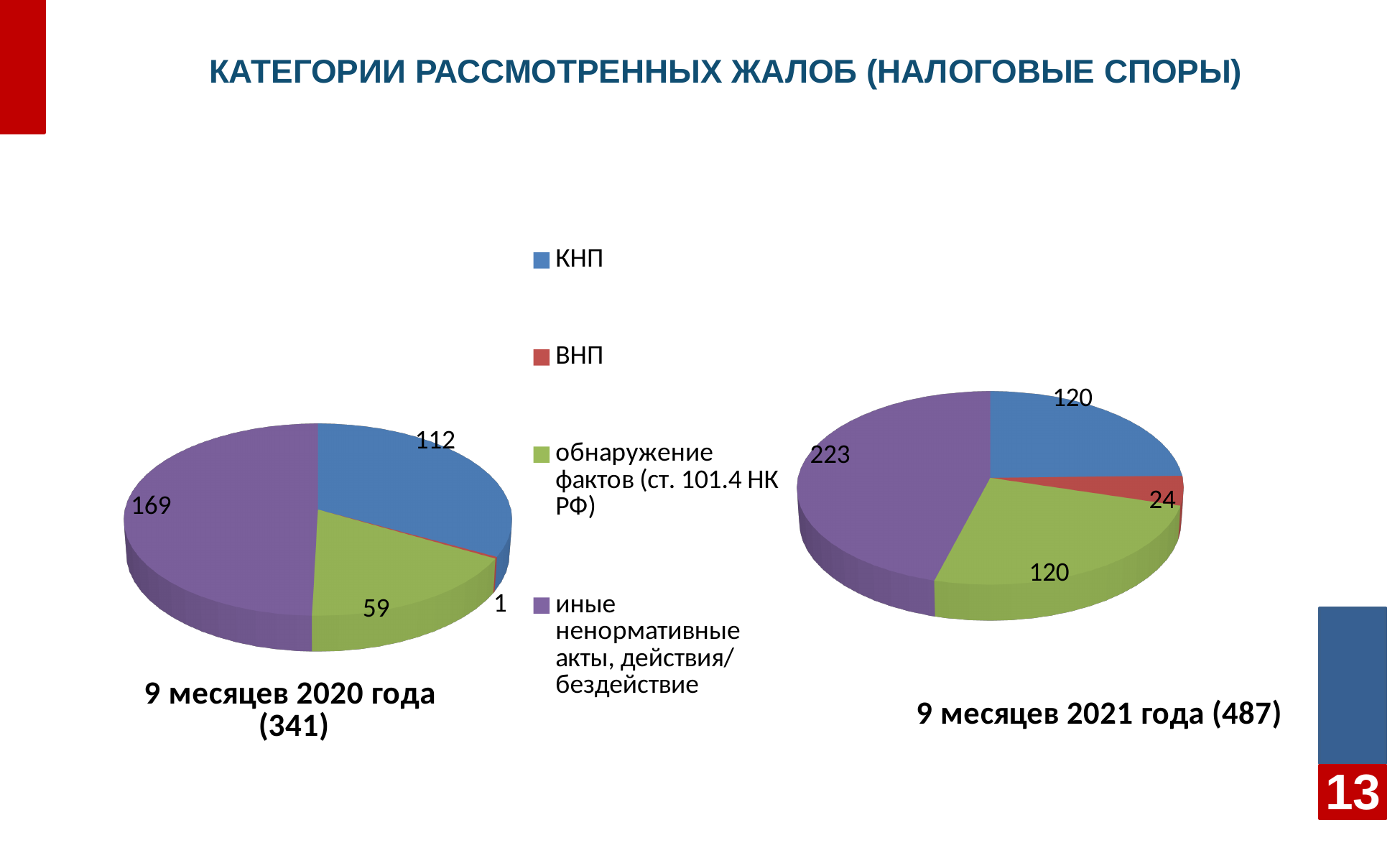
Which colour represents ВНП in the legend? Red In the pie chart titled "9 месяцев 2020 года (341)", what is the value for КНП? 112 What type of chart is used on the slide? Pie chart How many categories does each pie chart on the slide show? 4 In the pie chart titled "9 месяцев 2021 года (487)", what is the difference between the values for иные ненормативные акты, действия/бездействие and КНП? 103 In the pie chart titled "9 месяцев 2020 года (341)", which category has the largest slice? иные ненормативные акты, действия/бездействие In the pie chart titled "9 месяцев 2020 года (341)", which is larger: КНП or обнаружение фактов (ст. 101.4 НК РФ)? КНП In the pie chart titled "9 месяцев 2021 года (487)", what is the value for ВНП? 24 In the pie chart titled "9 месяцев 2021 года (487)", what is the value for иные ненормативные акты, действия/бездействие? 223 In the pie chart titled "9 месяцев 2021 года (487)", which category has the smallest slice? ВНП In the pie chart titled "9 месяцев 2020 года (341)", what is the value for обнаружение фактов (ст. 101.4 НК РФ)? 59 In the pie chart titled "9 месяцев 2020 года (341)", which category has the smallest slice? ВНП